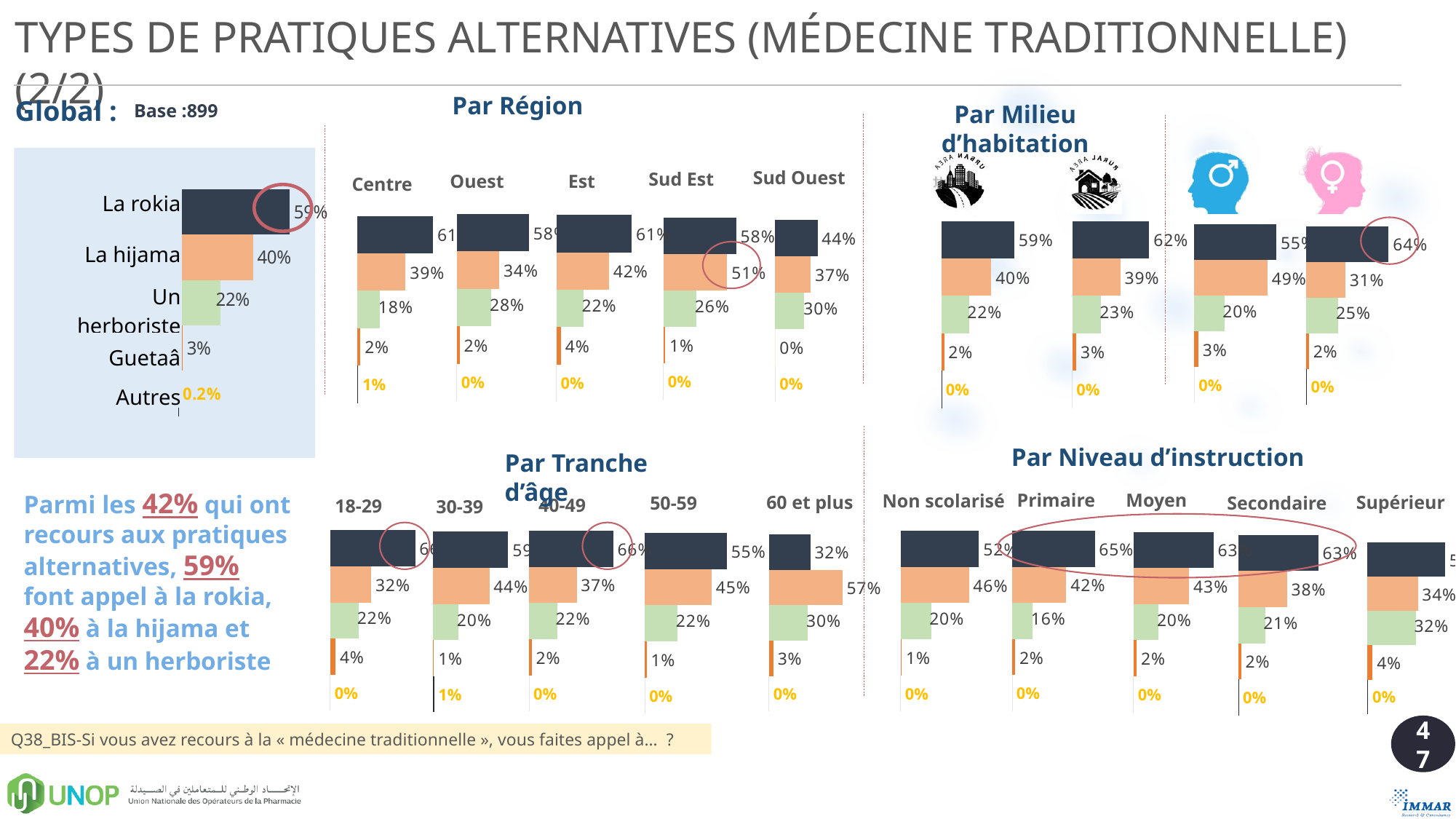
What kind of chart is the Global chart? Bar chart In the Global chart, what percentage is shown for Un herboriste? 22% In the Par Niveau d'instruction chart, which level has the highest value for the top (dark) bar among Non scolarisé, Primaire, Moyen and Secondaire? Primaire In the Par Région chart, which region has the highest value for the second (orange) bar? Sud Est In the Par Tranche d'âge chart, which age group has the lowest value for the top (dark) bar? 60 et plus In the Par Milieu d'habitation chart, is the top (dark) bar value for the female icon larger or smaller than for the male icon? Larger In the Global chart, which practice has the lowest percentage? Autres In the Global chart, how many practices are listed? 5 In the Global chart, what percentage is shown for La rokia? 59% In the Par Tranche d'âge chart, what is the value of the second (orange) bar for 60 et plus? 57% In the Global chart, what is the difference between the percentages for La rokia and La hijama? 19% In the Par Région chart, what is the value of the top (dark) bar for Sud Ouest? 44%